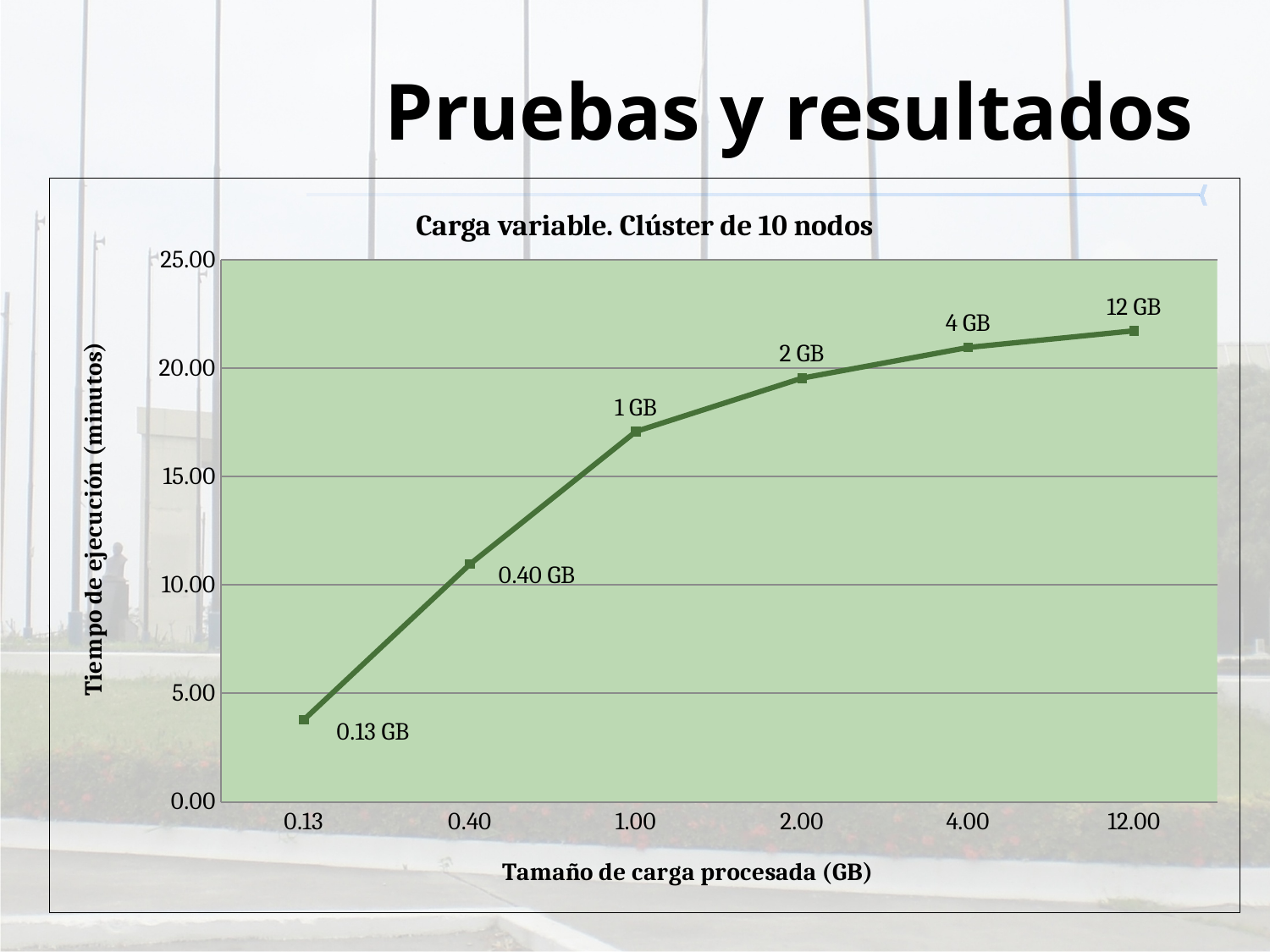
Is the execution time for the 1 GB load greater or less than 15.00 minutes? greater Which load size has the highest execution time? 12.00 What kind of chart is shown on the slide? Line chart Does the execution time rise or fall as the load size increases along the x axis? Rise How many data points are plotted on the chart? 6 Is the execution time for the 0.13 GB load greater or less than 5.00 minutes? less Is the execution time for the 4 GB load greater or less than 20.00 minutes? greater Which load size has the lowest execution time? 0.13 Which has a higher execution time, the 0.40 GB load or the 1 GB load? 1 GB What is the title of the chart? Carga variable. Clúster de 10 nodos